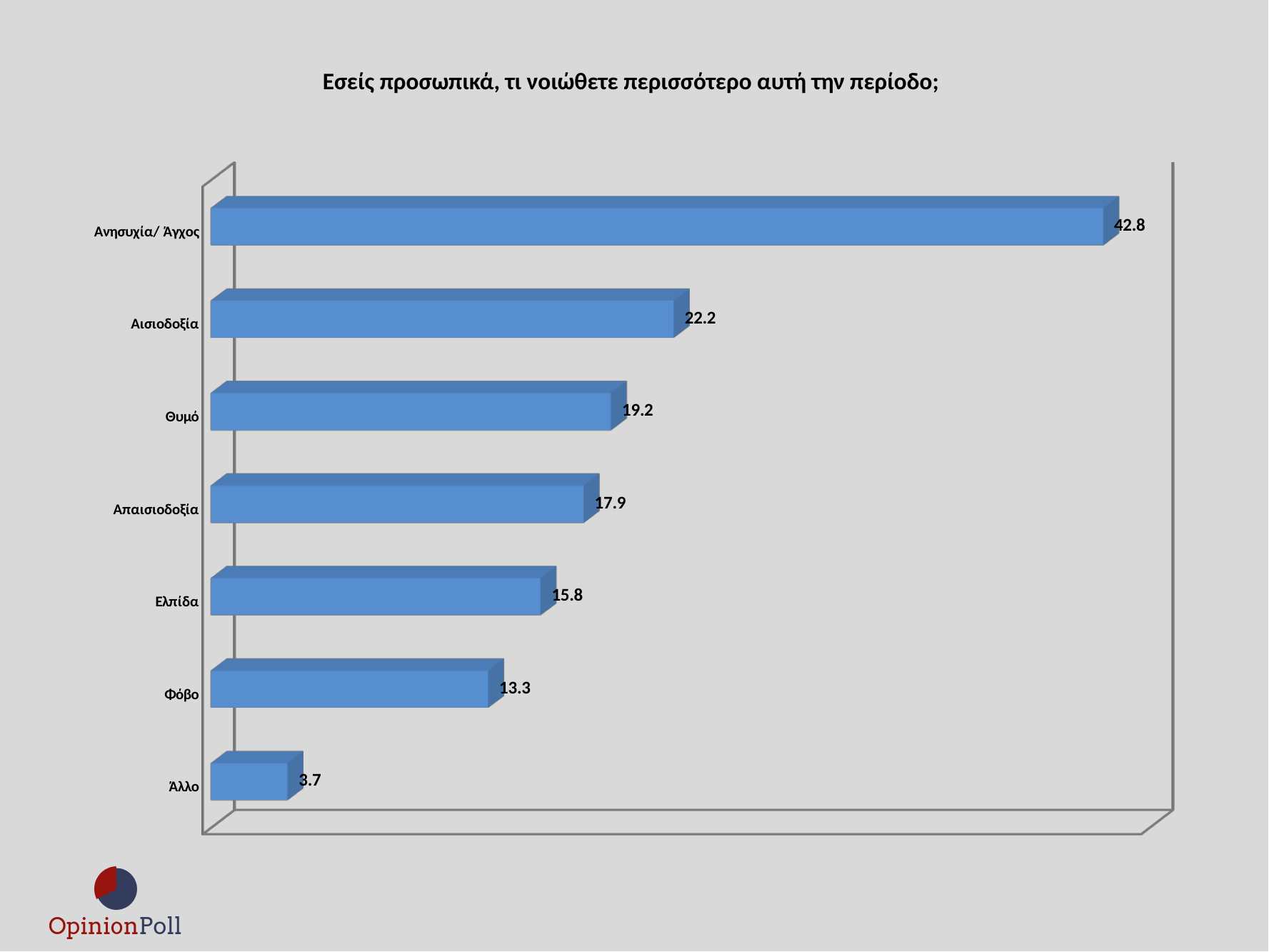
What is the value for Θυμό? 19.2 What is the title of the chart? Εσείς προσωπικά, τι νοιώθετε περισσότερο αυτή την περίοδο; What kind of chart is shown on the slide? Bar chart What is the value for Φόβο? 13.3 What is the difference between the values for Ανησυχία/ Άγχος and Αισιοδοξία? 20.6 What is the value for Αισιοδοξία? 22.2 Which category has the lowest value? Άλλο Which category has the highest value? Ανησυχία/ Άγχος What is the value for Ελπίδα? 15.8 What is the value for Ανησυχία/ Άγχος? 42.8 Which is larger, the value for Απαισιοδοξία or the value for Ελπίδα? Απαισιοδοξία How many categories are shown in the chart? 7